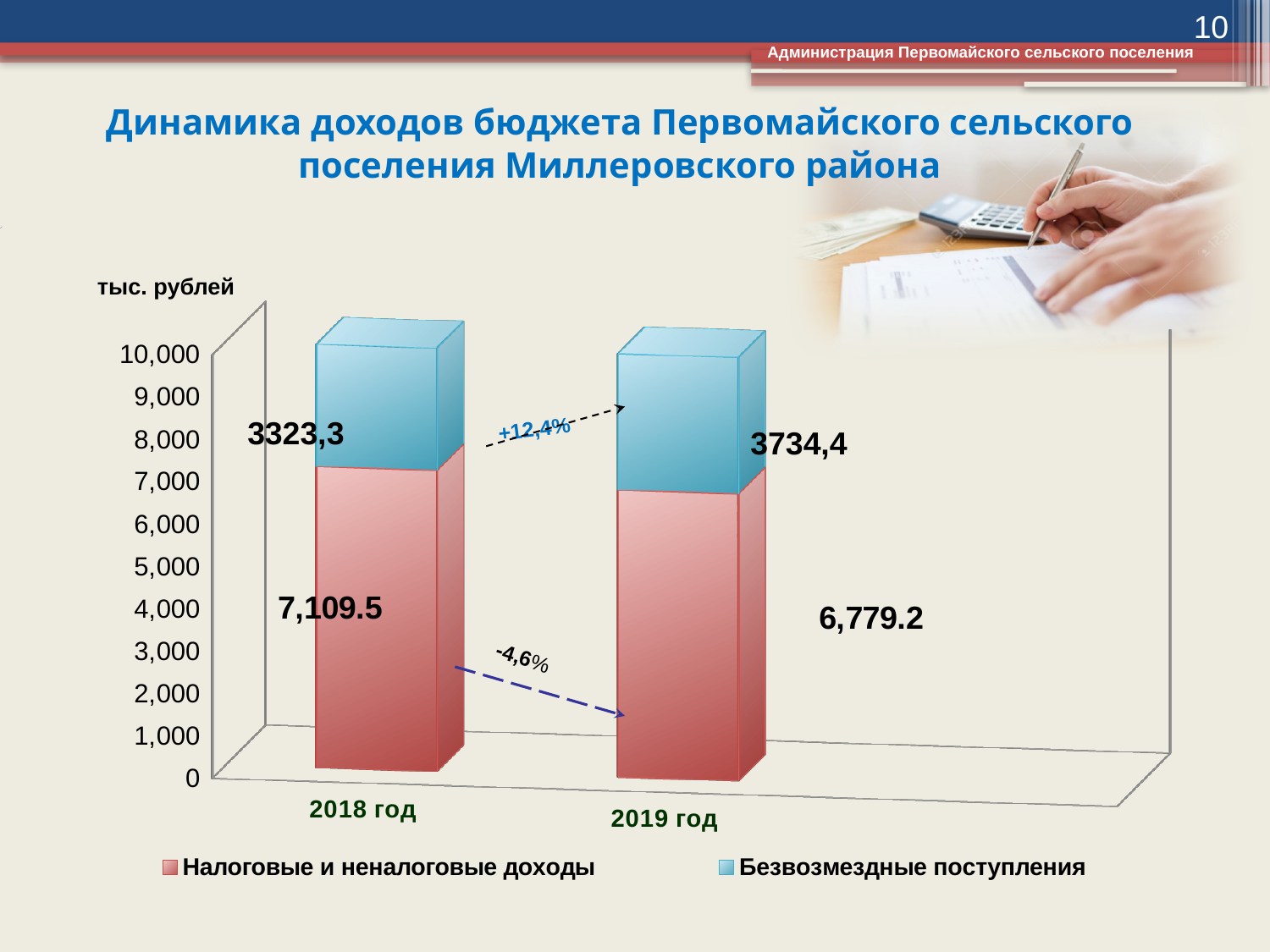
What is the value of Безвозмездные поступления for 2019 год? 3734,4 What percentage change is shown for Безвозмездные поступления between 2018 and 2019? +12,4% What unit of measurement is indicated for the chart values? тыс. рублей What type of chart is shown on the slide? Stacked bar chart Which year has the higher value for Безвозмездные поступления? 2019 год What is the value of Налоговые и неналоговые доходы for 2018 год? 7,109.5 What is the value of Налоговые и неналоговые доходы for 2019 год? 6,779.2 How many categories (years) are shown on the x axis? 2 How many series does the legend list? 2 What is the value of Безвозмездные поступления for 2018 год? 3323,3 Which year has the lower value for Налоговые и неналоговые доходы? 2019 год By how much did Налоговые и неналоговые доходы decrease from 2018 год to 2019 год? 330.3